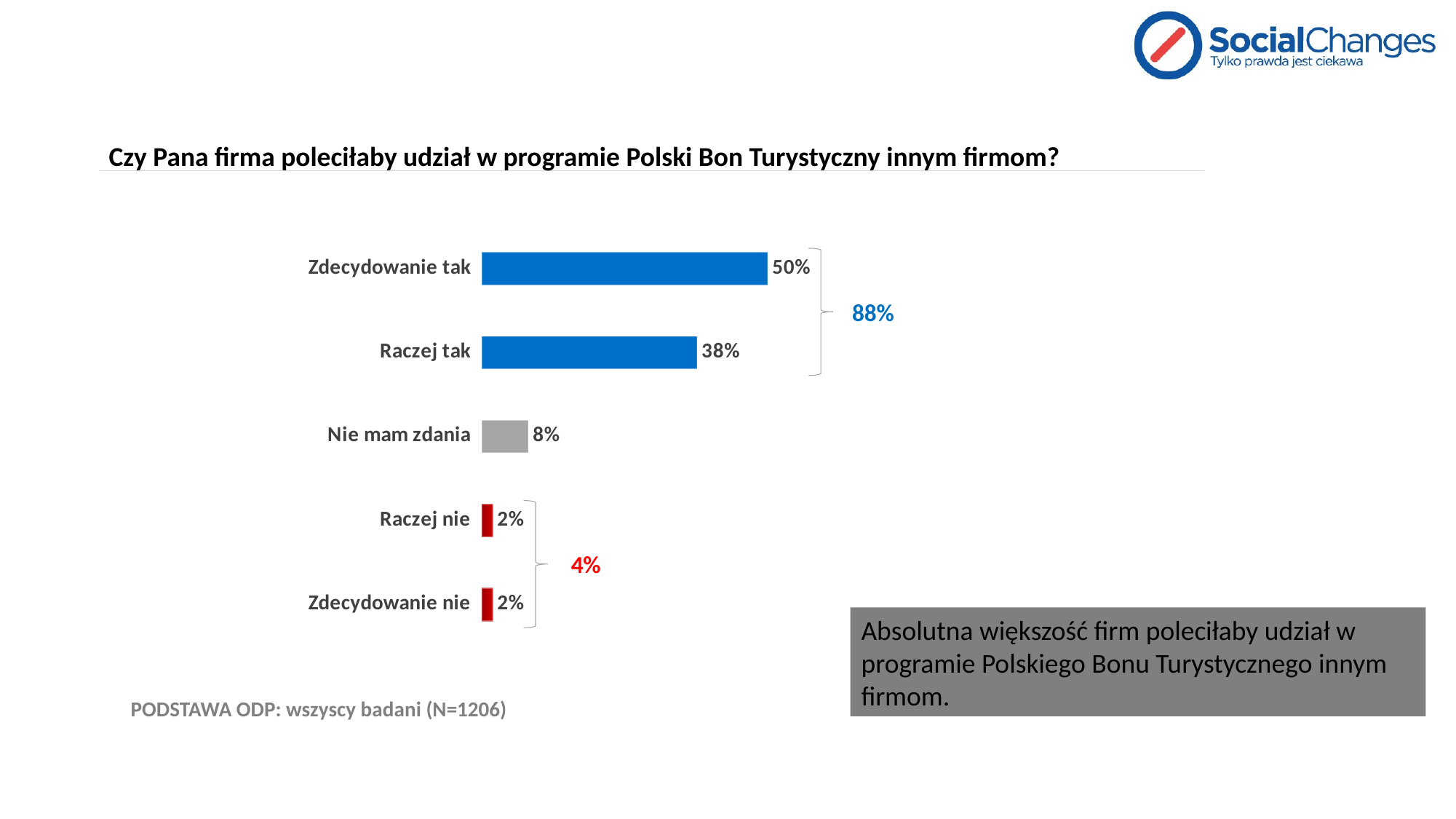
What is the difference between "Zdecydowanie tak" and "Raczej tak"? 12 percentage points How many response categories are shown in the chart? 5 What colour are the bars for "Raczej nie" and "Zdecydowanie nie"? Red What combined percentage is shown by the bracket grouping "Raczej nie" and "Zdecydowanie nie"? 4% What type of chart is shown on the slide? Bar chart What is the value shown for "Raczej tak"? 38% What percentage of respondents answered "Zdecydowanie tak"? 50% What percentage answered "Nie mam zdania"? 8% Which is larger, the value for "Raczej tak" or the value for "Nie mam zdania"? Raczej tak Which response category has the highest value? Zdecydowanie tak What is the value for "Zdecydowanie nie"? 2% What combined percentage is shown by the bracket grouping "Zdecydowanie tak" and "Raczej tak"? 88%